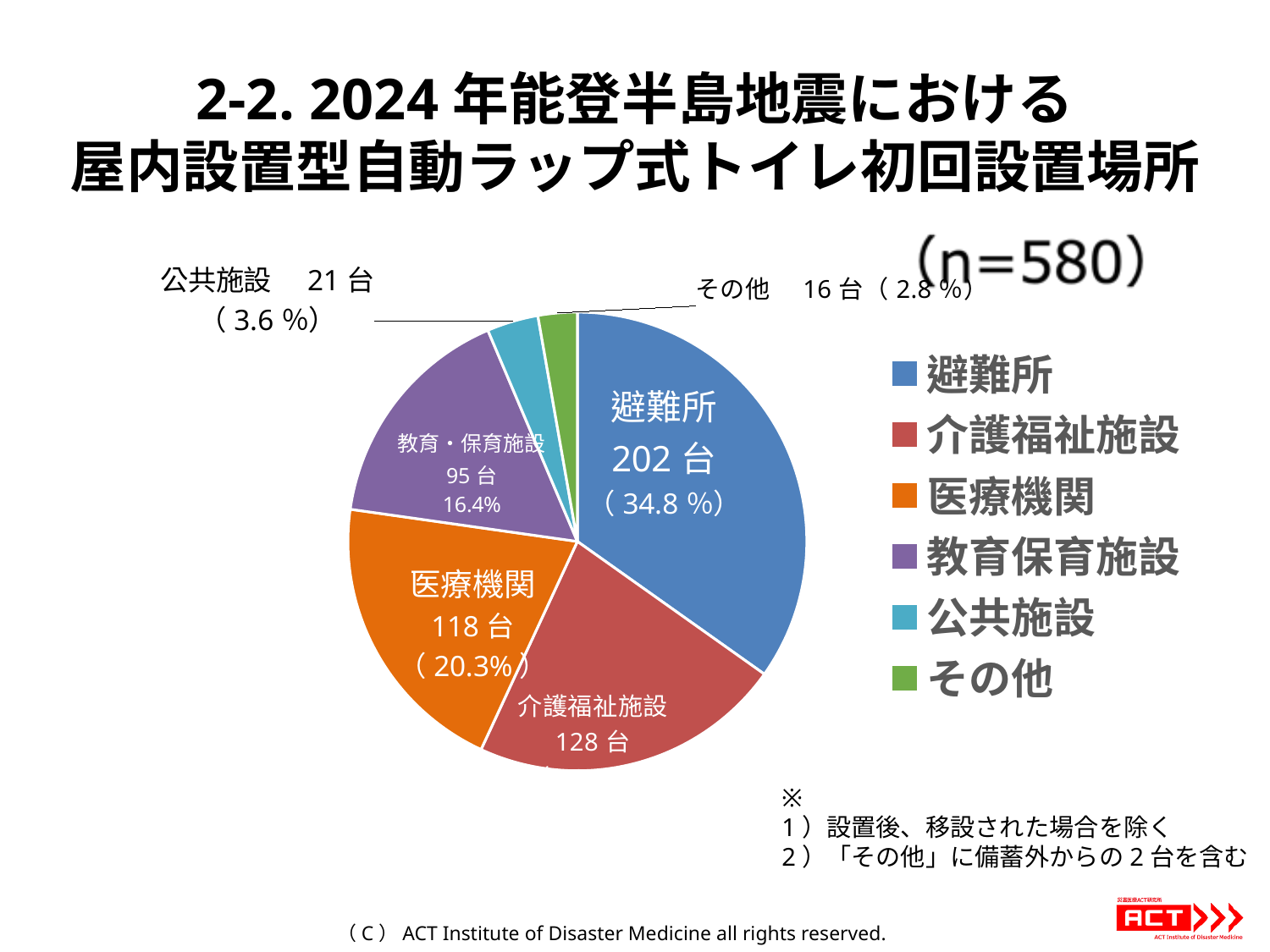
Which category has the smallest slice of the pie? その他 How many units (台) are shown for 避難所? 202 台 How many units (台) are shown for 介護福祉施設? 128 台 How many units (台) are shown for 医療機関? 118 台 How many categories does the legend list? 6 What percentage share of the pie does 医療機関 have? 20.3% What is the difference in units between 避難所 and 介護福祉施設? 74 台 What kind of chart is shown on the slide? pie chart What percentage share of the pie does 教育・保育施設 have? 16.4% How many units (台) are shown for 公共施設? 21 台 Which category has the largest slice of the pie? 避難所 Which has more units, 医療機関 or 教育・保育施設? 医療機関